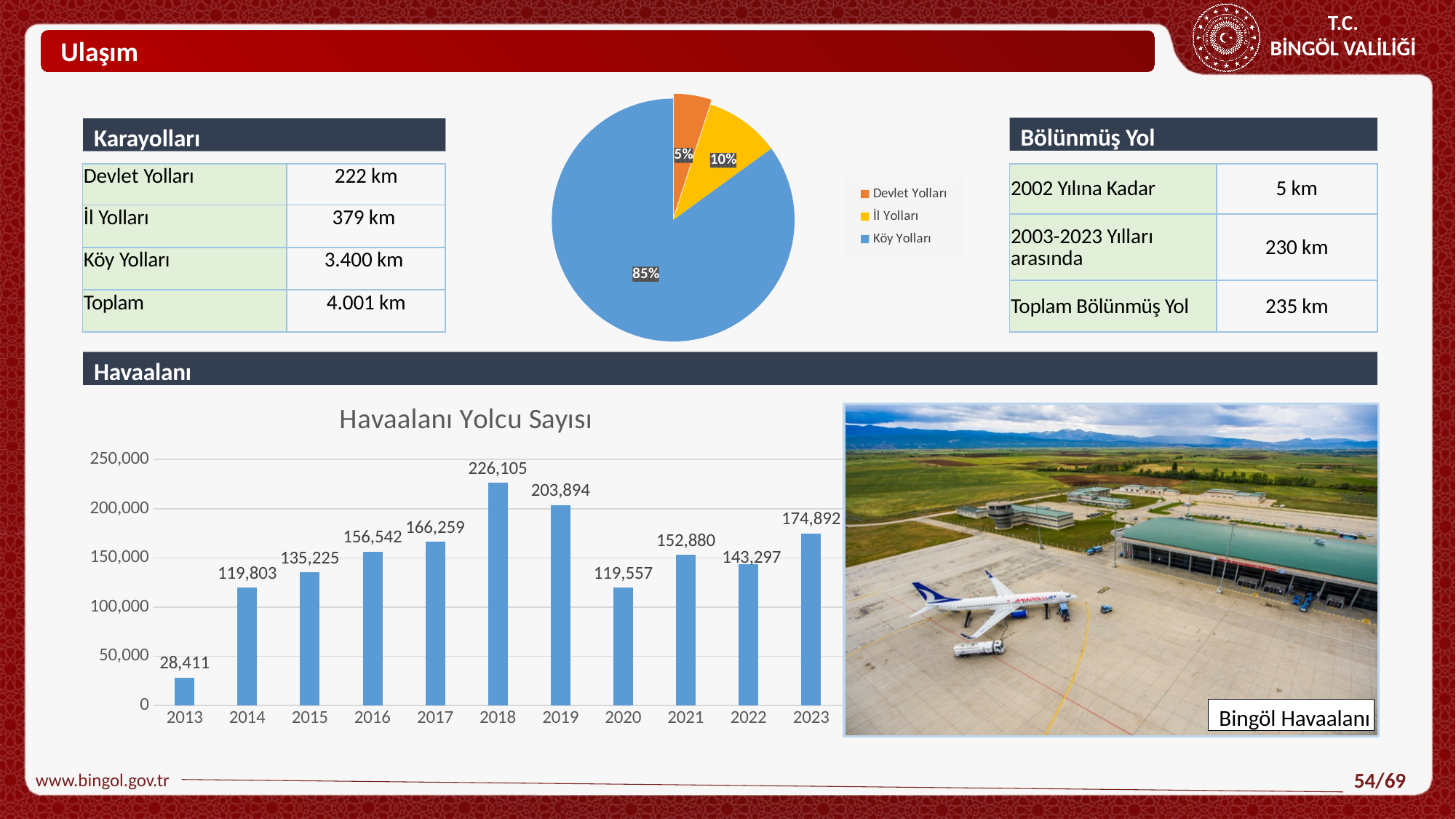
In the bar chart 'Havaalanı Yolcu Sayısı', which year has the highest value? 2018 In the bar chart 'Havaalanı Yolcu Sayısı', what is the difference between the values for 2018 and 2019? 22,211 How many entries does the legend of the pie chart at the top of the slide list? 3 In the bar chart 'Havaalanı Yolcu Sayısı', how many years are shown on the x axis? 11 What kind of chart is 'Havaalanı Yolcu Sayısı'? Bar chart In the bar chart 'Havaalanı Yolcu Sayısı', do the values rise or fall from 2013 to 2018? Rise In the bar chart 'Havaalanı Yolcu Sayısı', what is the value for 2023? 174,892 In the pie chart at the top of the slide, what share does Köy Yolları have? 85% In the bar chart 'Havaalanı Yolcu Sayısı', what is the value for 2018? 226,105 In the pie chart at the top of the slide, what share does Devlet Yolları have? 5% In the bar chart 'Havaalanı Yolcu Sayısı', which is larger, the value for 2016 or the value for 2021? 2016 In the bar chart 'Havaalanı Yolcu Sayısı', which year has the lowest value? 2013